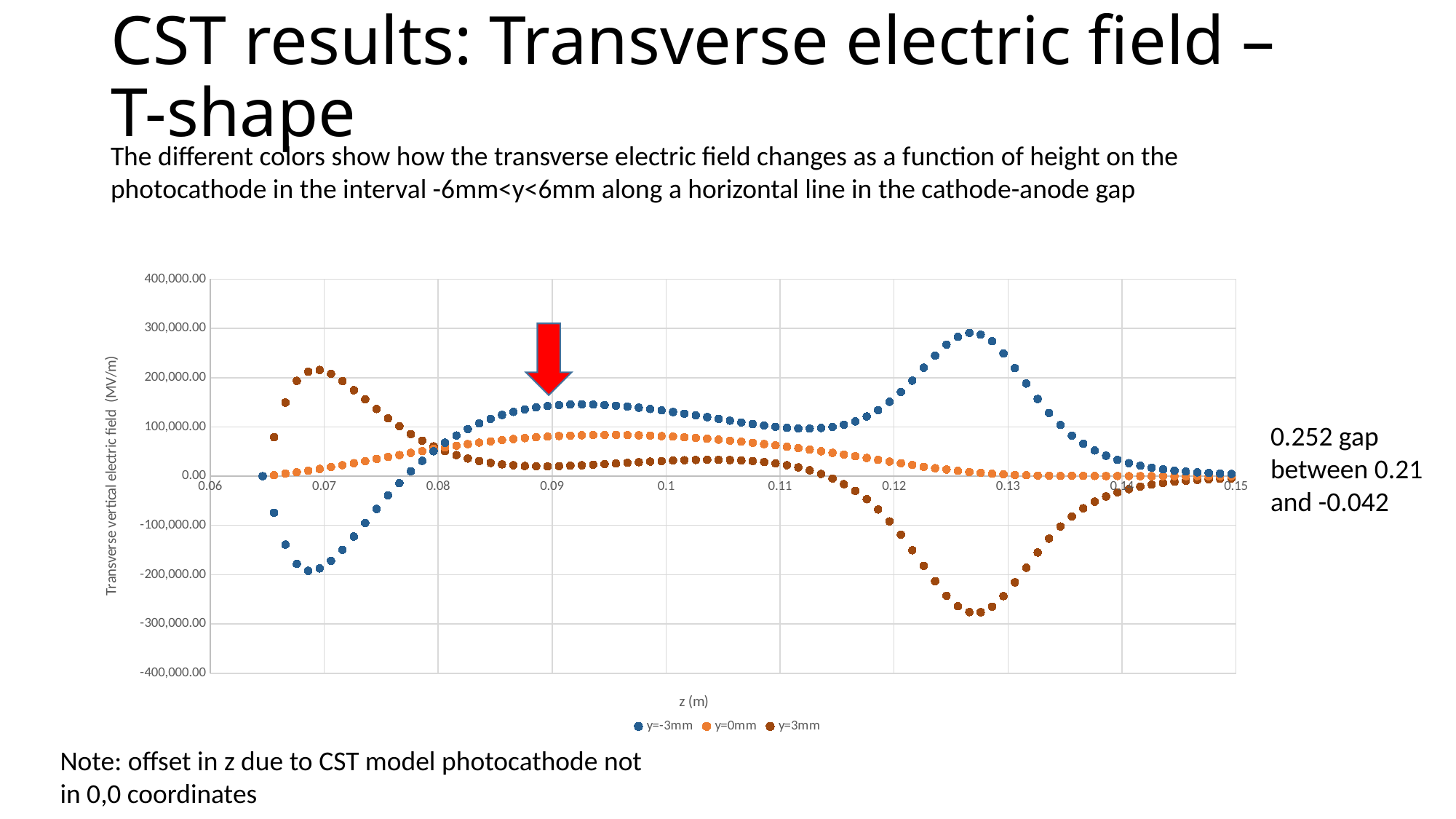
What is the label of the x axis? z (m) Is the lowest value reached by the y=3mm series greater or less than -200,000.00? less At z=0.07, which series has the larger value, y=3mm or y=-3mm? y=3mm What kind of chart is shown on the slide? scatter chart How many series does the legend list? 3 Is the highest value reached by the y=-3mm series greater or less than 200,000.00? greater At z=0.09, which series has the larger value, y=-3mm or y=0mm? y=-3mm Is the value for y=-3mm at z=0.09 greater or less than 100,000.00? greater Which series is plotted in blue? y=-3mm Which series reaches the highest value on the chart? y=-3mm